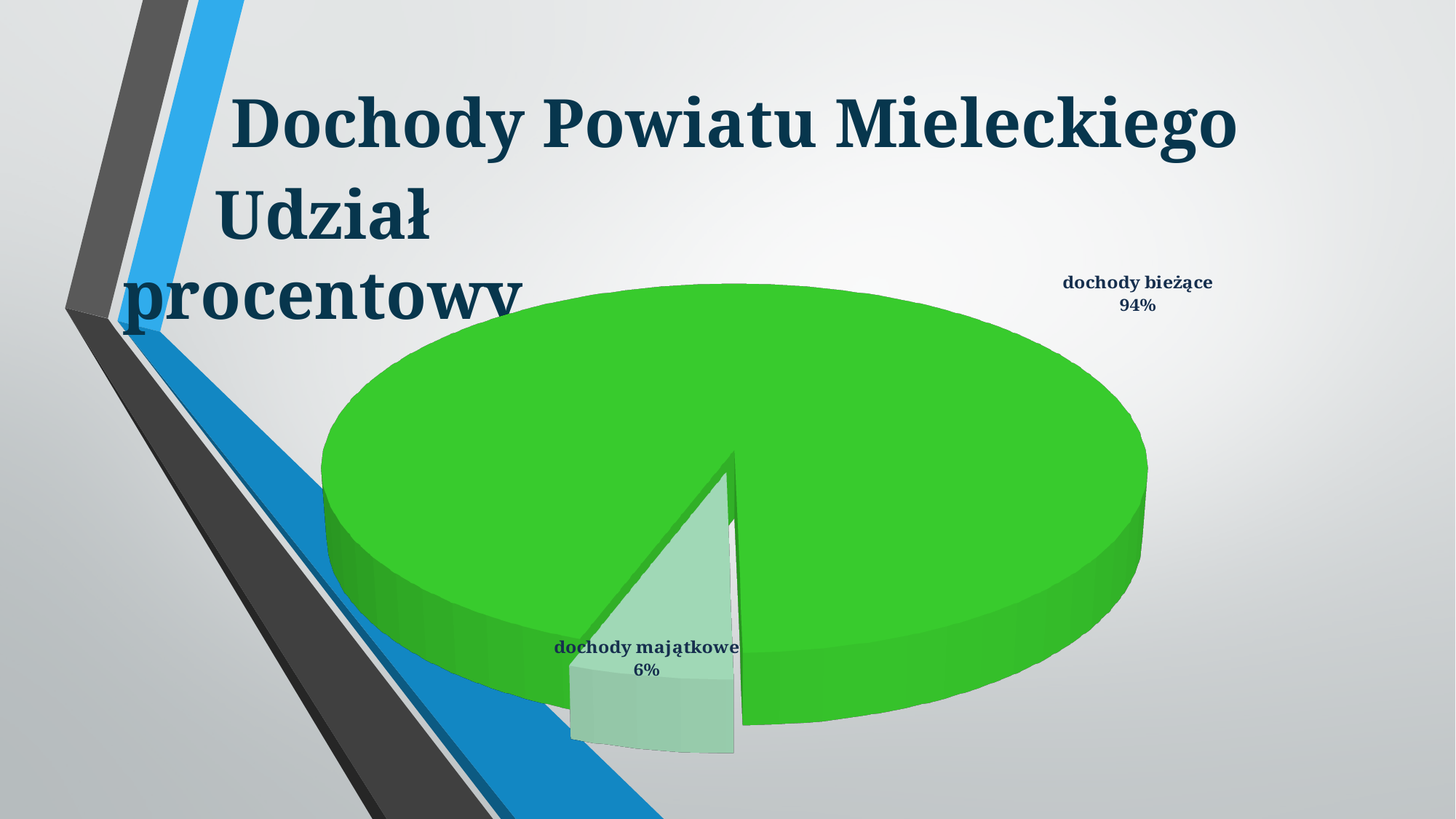
What is the title of the chart on the slide? Dochody Powiatu Mieleckiego Udział procentowy Which slice of the pie is the smallest? dochody majątkowe What share of the pie does dochody majątkowe have? 6% What share of the pie does dochody bieżące have? 94% What kind of chart is shown on the slide? pie chart Which slice of the pie is the largest? dochody bieżące How many slices does the pie chart have? 2 Which is larger, dochody bieżące or dochody majątkowe? dochody bieżące What is the difference in percentage points between dochody bieżące and dochody majątkowe? 88 What colour is the dochody bieżące slice? green